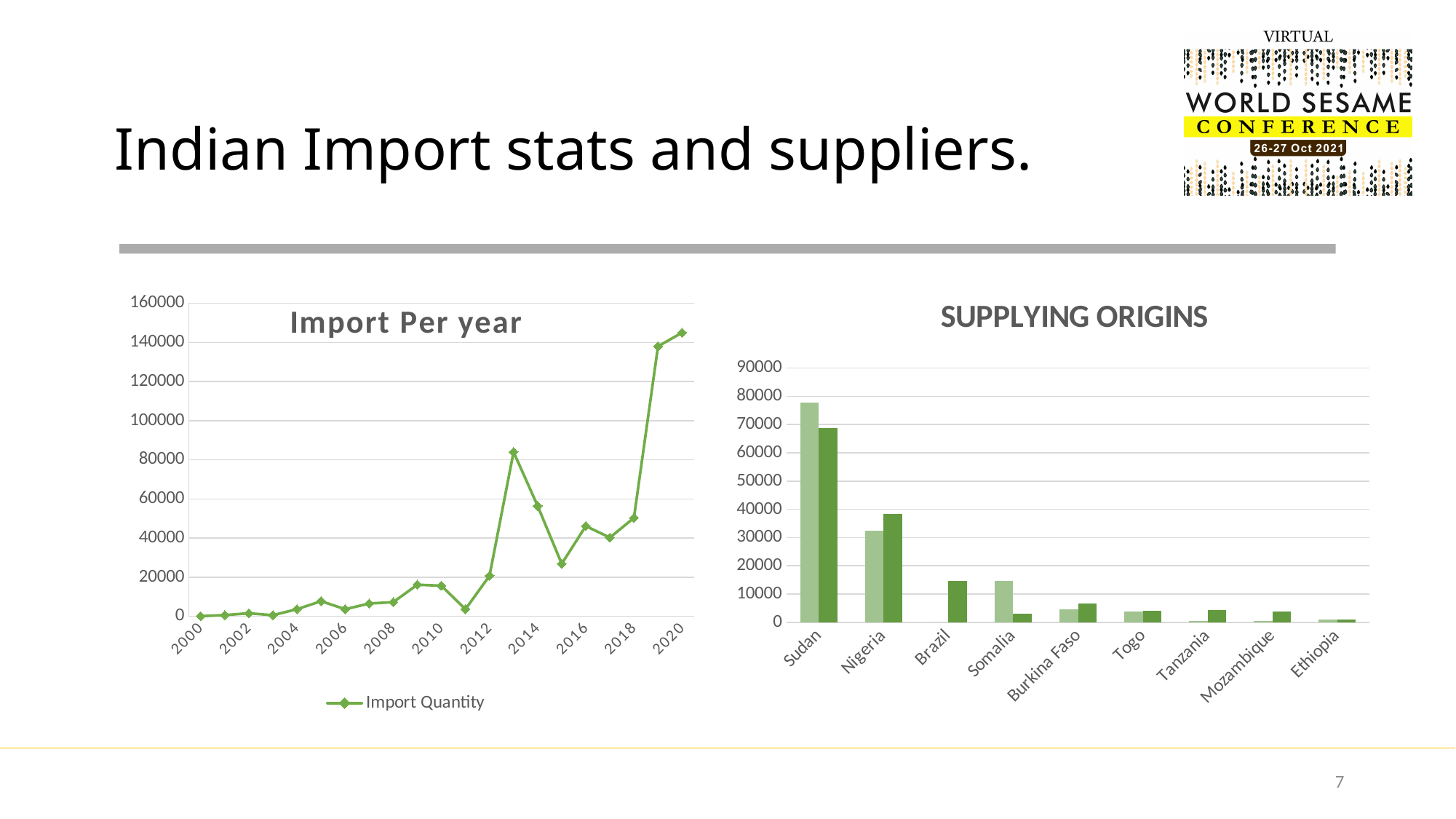
What kind of chart is the 'Import Per year' chart? line chart In the 'Import Per year' chart, how many series does the legend list? 1 In the 'SUPPLYING ORIGINS' chart, which has the larger light green bar, Somalia or Burkina Faso? Somalia In the 'Import Per year' chart, is the value for 2019 greater or less than 120000? greater In the 'Import Per year' chart, is the value for 2015 greater or less than 40000? less What kind of chart is the 'SUPPLYING ORIGINS' chart? bar chart In the 'SUPPLYING ORIGINS' chart, which country has the highest bar? Sudan In the 'SUPPLYING ORIGINS' chart, is the light green bar for Sudan greater or less than 70000? greater In the 'Import Per year' chart, what is the name of the series in the legend? Import Quantity In the 'SUPPLYING ORIGINS' chart, how many countries are shown on the x axis? 9 In the 'Import Per year' chart, which year has the highest import quantity? 2020